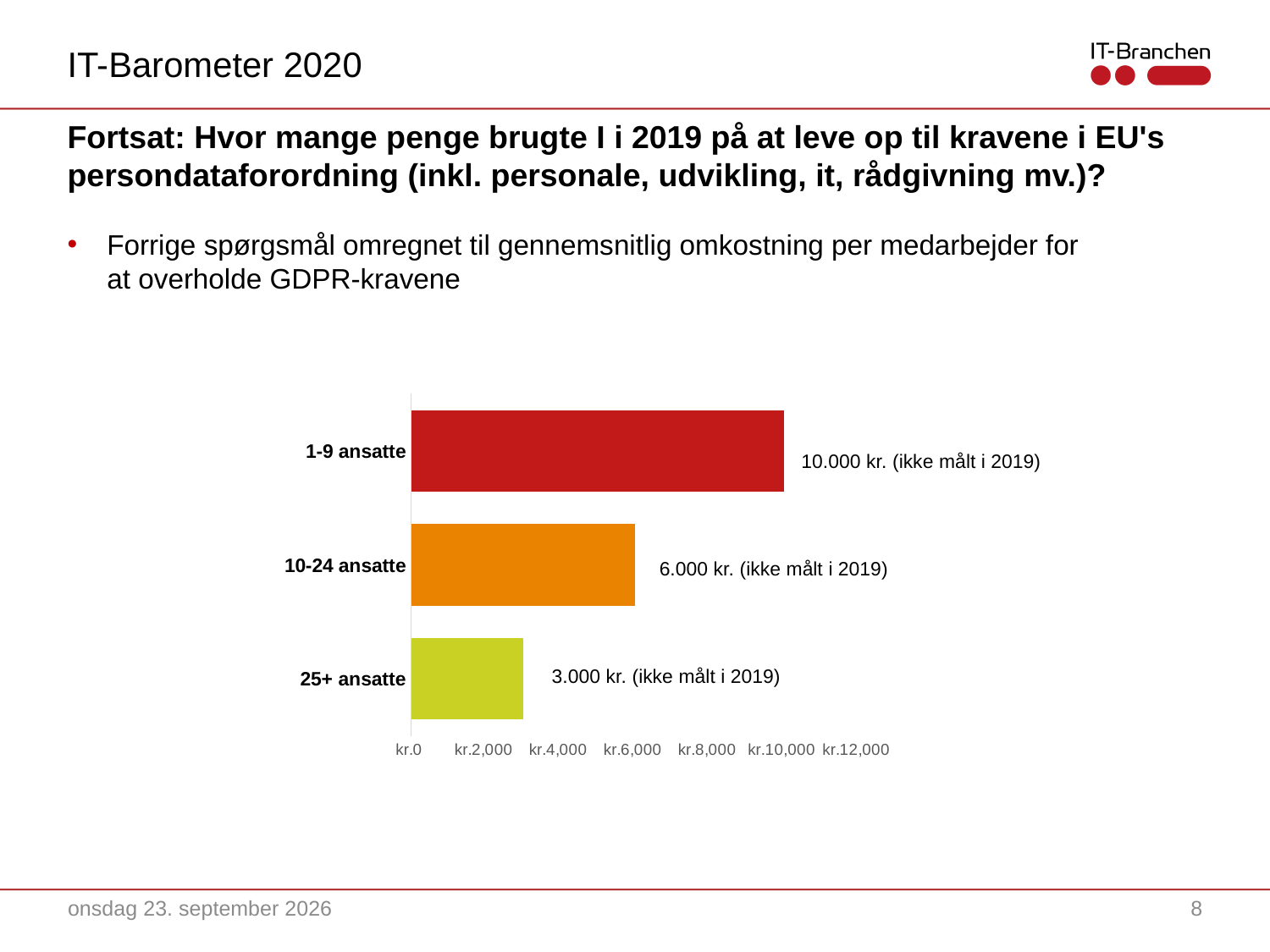
What is the value for 1-9 ansatte? 10.000 kr. Which category has the lowest value? 25+ ansatte How many categories are shown in the chart? 3 Which category has the highest value? 1-9 ansatte Which is larger, the value for 10-24 ansatte or the value for 25+ ansatte? 10-24 ansatte What kind of chart is shown on the slide? bar chart Is the value for 10-24 ansatte greater or less than kr.4,000? greater What colour is the bar for 25+ ansatte? yellow-green What is the value for 10-24 ansatte? 6.000 kr. What is the difference between the values for 1-9 ansatte and 10-24 ansatte? 4.000 kr. What is the difference between the values for 1-9 ansatte and 25+ ansatte? 7.000 kr. What is the value for 25+ ansatte? 3.000 kr.